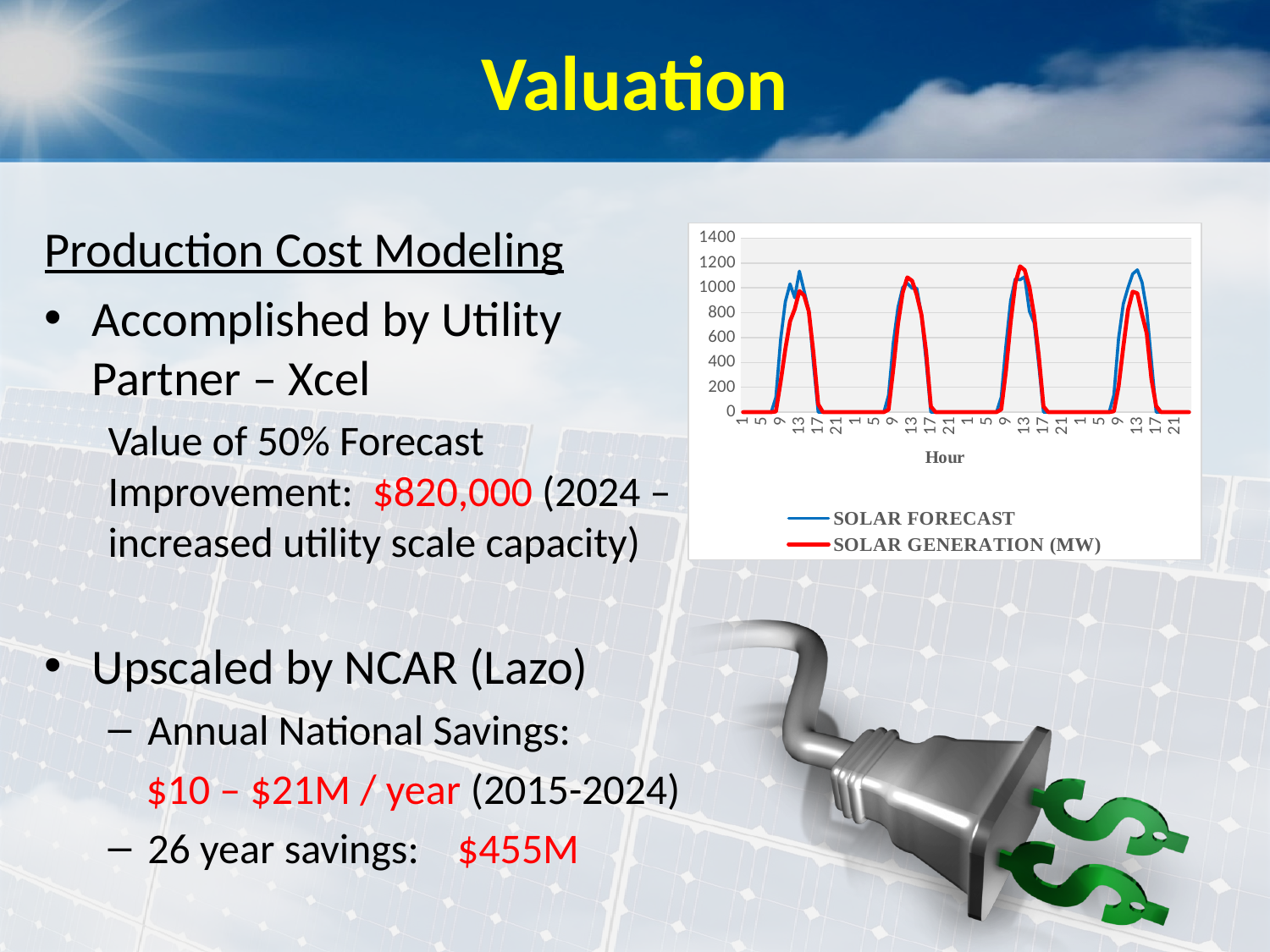
In the first daily cycle, which series reaches the higher peak, SOLAR FORECAST or SOLAR GENERATION (MW)? SOLAR FORECAST Is the first peak of the SOLAR FORECAST series greater or less than 1000? greater What kind of chart is shown on the slide? line chart How many series does the chart's legend list? 2 What are the two series named in the chart's legend? SOLAR FORECAST and SOLAR GENERATION (MW) How many daily peaks (cycles) are plotted in the chart? 4 Is the highest peak of the SOLAR GENERATION (MW) series greater or less than 1000? greater Is the highest peak of the SOLAR FORECAST series greater or less than 1400? less What is the title of the chart's x axis? Hour What is the value of both series at hour 1 of the first day? 0 In the third daily cycle, which series reaches the higher peak, SOLAR FORECAST or SOLAR GENERATION (MW)? SOLAR GENERATION (MW)